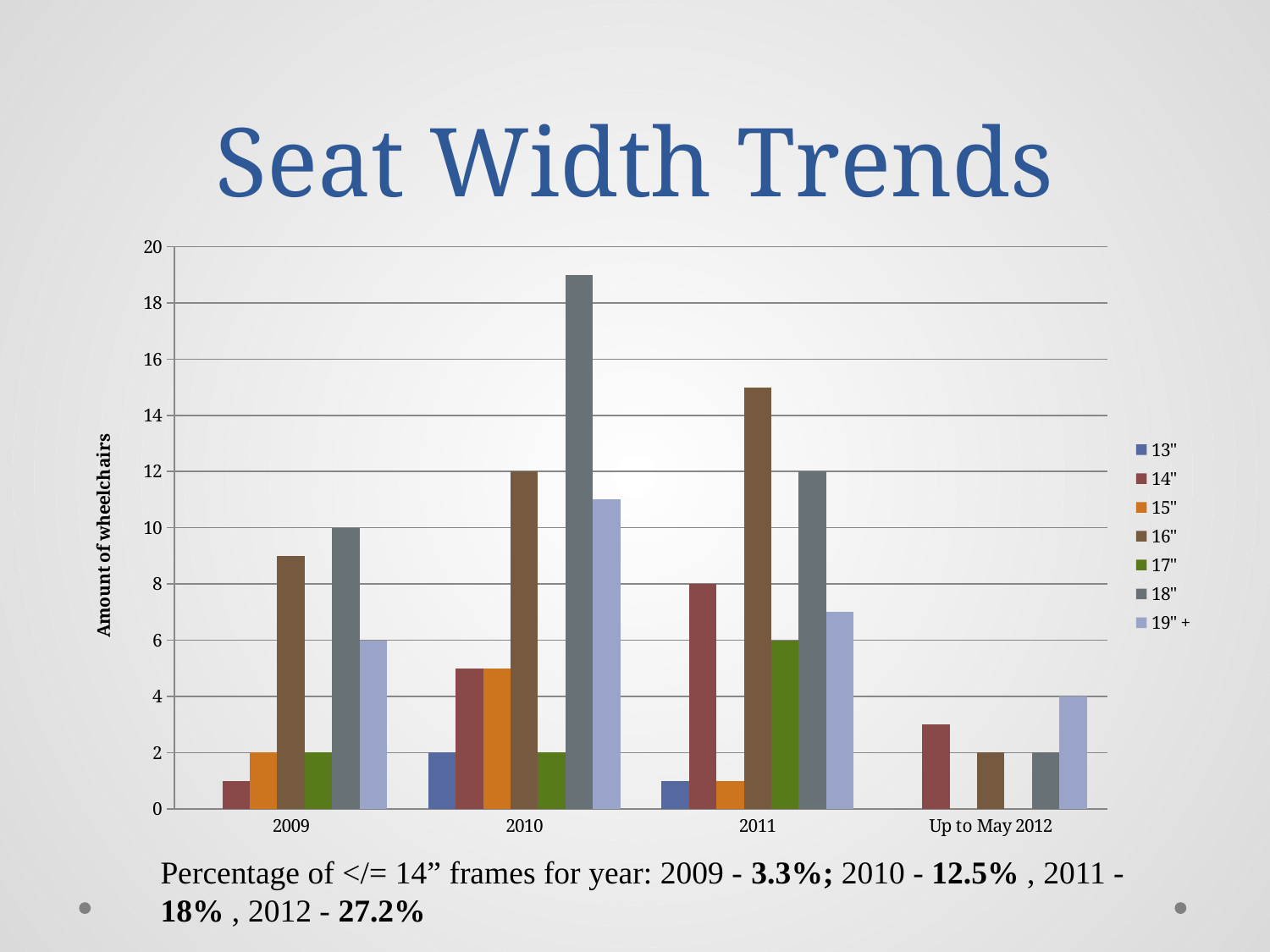
Is the value for 18" in 2010 greater or less than 18? greater What is the difference between the 18" value and the 17" value in 2011? 6 What is the value for 14" in 2011? 8 Which series has the tallest bar in 2010? 18" What is the value for 18" in 2009? 10 What is the value for 16" in 2010? 12 What kind of chart is shown on the slide? bar chart How many year categories are shown on the x axis? 4 How many series does the legend list? 7 In 2011, which is larger, the value for 16" or the value for 18"? 16" What is the value for 19" + in Up to May 2012? 4 Is the value for 16" in 2011 greater or less than 14? greater